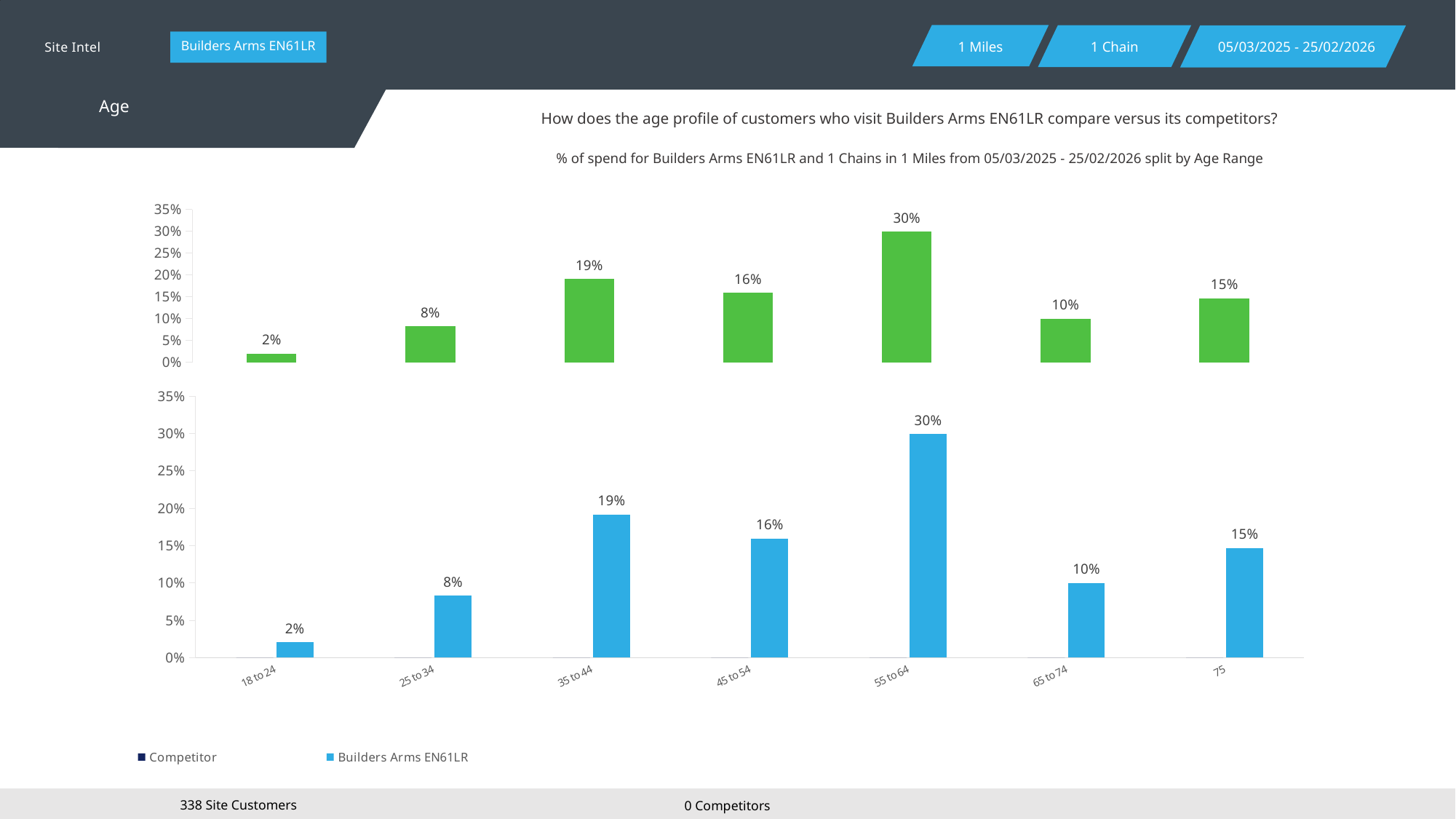
In the bottom chart, which age range has the lowest value? 18 to 24 In the bottom chart, what is the difference between the values for 35 to 44 and 45 to 54? 3% What colour are the bars in the top chart? Green In the bottom chart, what is the value for the 55 to 64 age range? 30% In the top chart, what is the highest value labelled on any bar? 30% How many series does the legend below the bottom chart list? 2 What kind of chart is the top chart on the slide? Bar chart How many age range categories are shown on the x axis of the bottom chart? 7 In the bottom chart, which age range has the highest value? 55 to 64 In the bottom chart, what is the value for the 65 to 74 age range? 10% In the bottom chart, which is larger: the value for 25 to 34 or the value for 75? 75 In the bottom chart, what is the value for the 18 to 24 age range? 2%